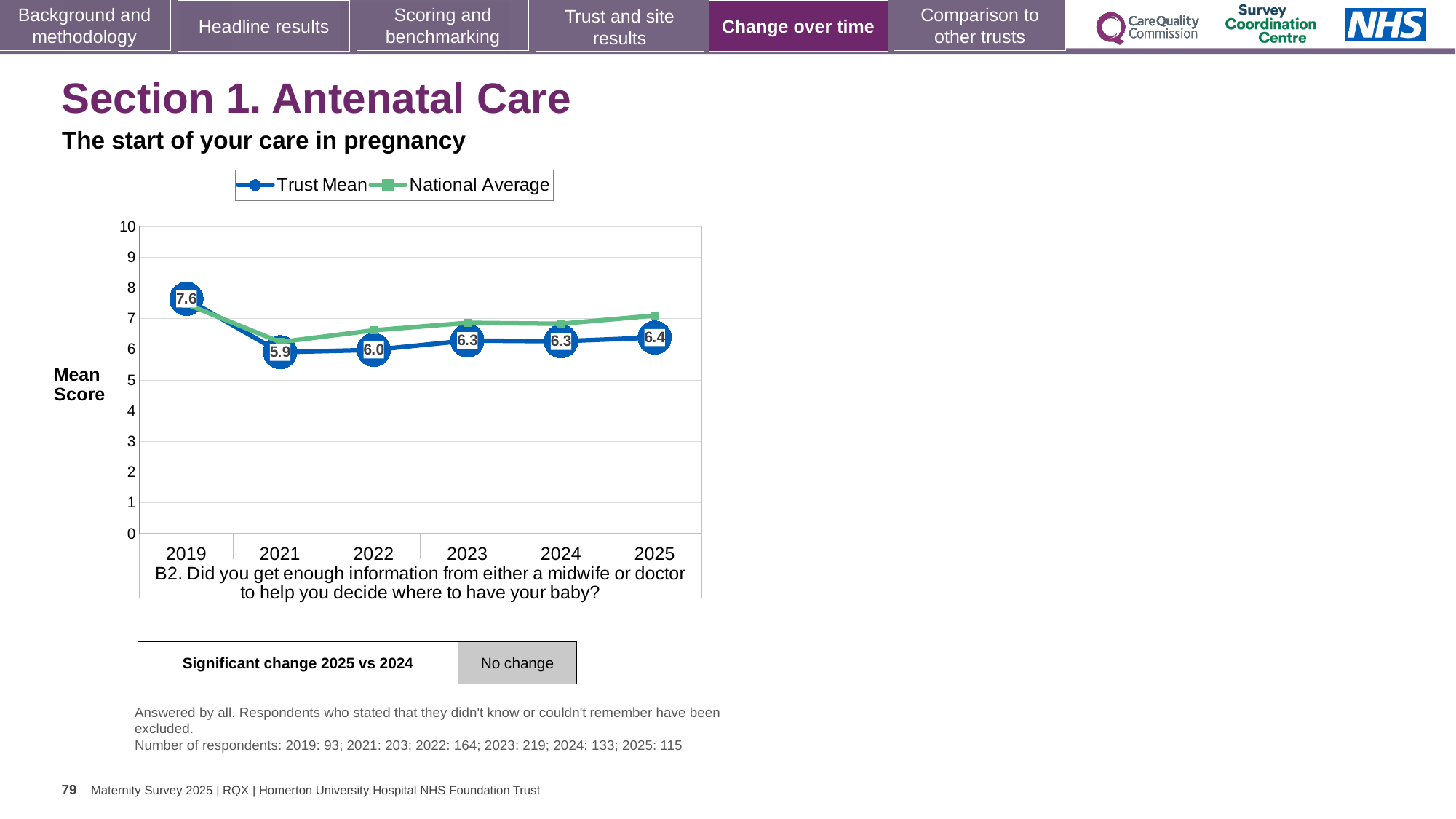
What is the Trust Mean score for 2025? 6.4 What is the Trust Mean score for 2019? 7.6 What kind of chart is shown on the slide? Line chart Which is larger, the Trust Mean in 2022 or in 2025? 2025 In which year is the Trust Mean highest? 2019 Does the Trust Mean rise or fall from 2021 to 2025? Rise How many years are plotted on the x axis? 6 Is the National Average value for 2023 greater or less than 6? greater What is the difference between the Trust Mean in 2019 and in 2021? 1.7 What is the Trust Mean score for 2021? 5.9 In which year is the Trust Mean lowest? 2021 How many series does the legend list? 2